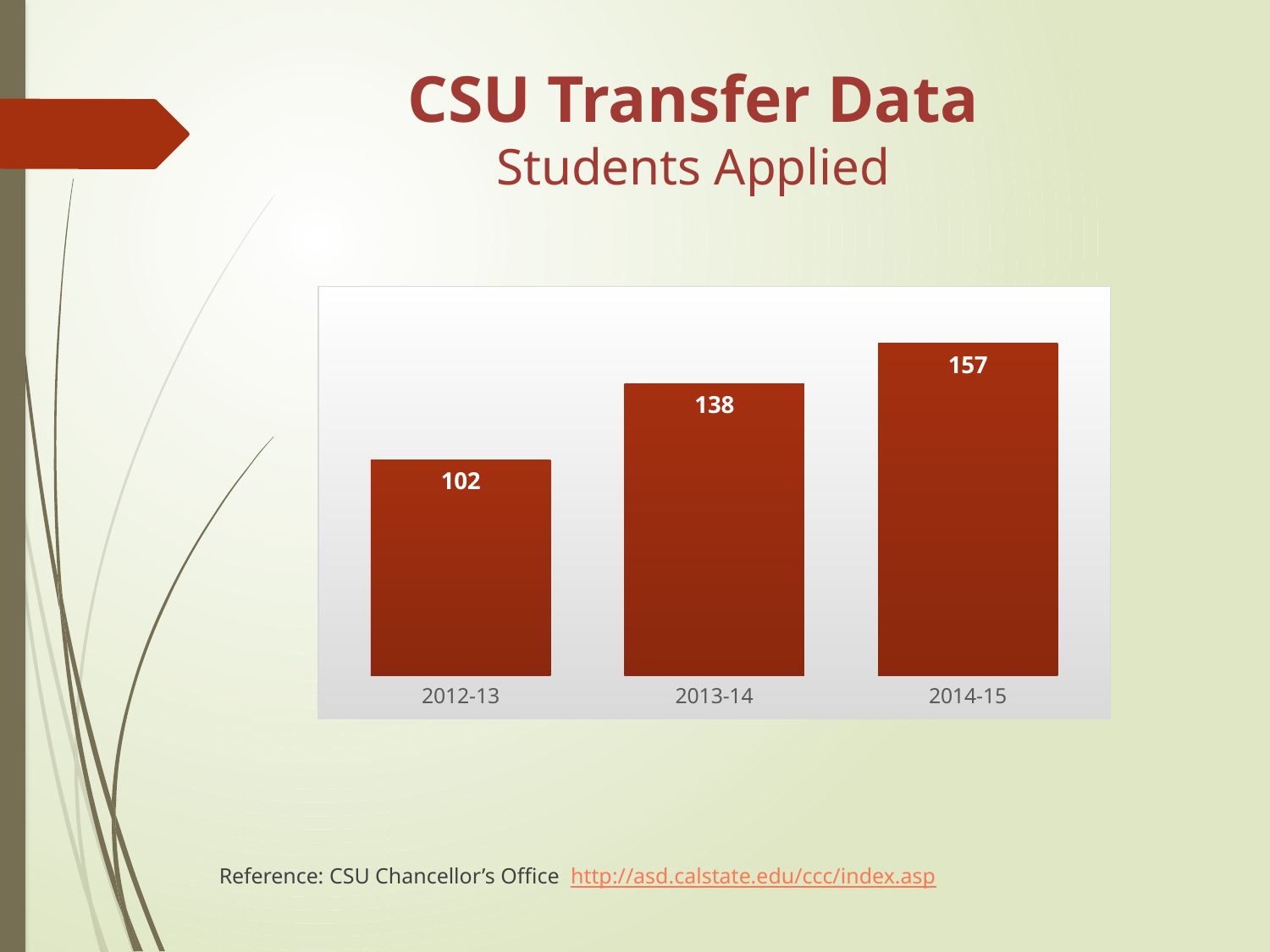
Which is larger, the value for 2013-14 or the value for 2014-15? 2014-15 By how much did the value increase from 2012-13 to 2013-14? 36 What is the subtitle of the chart on the slide? Students Applied How many students applied in 2012-13? 102 Which year has the lowest number of students applied? 2012-13 What kind of chart is shown on the slide? Bar chart Do the values rise or fall from 2012-13 to 2014-15? Rise What is the value shown for 2014-15? 157 How many years are shown on the chart? 3 What is the value shown for 2013-14? 138 Which year has the highest number of students applied? 2014-15 What is the difference between the values for 2014-15 and 2012-13? 55